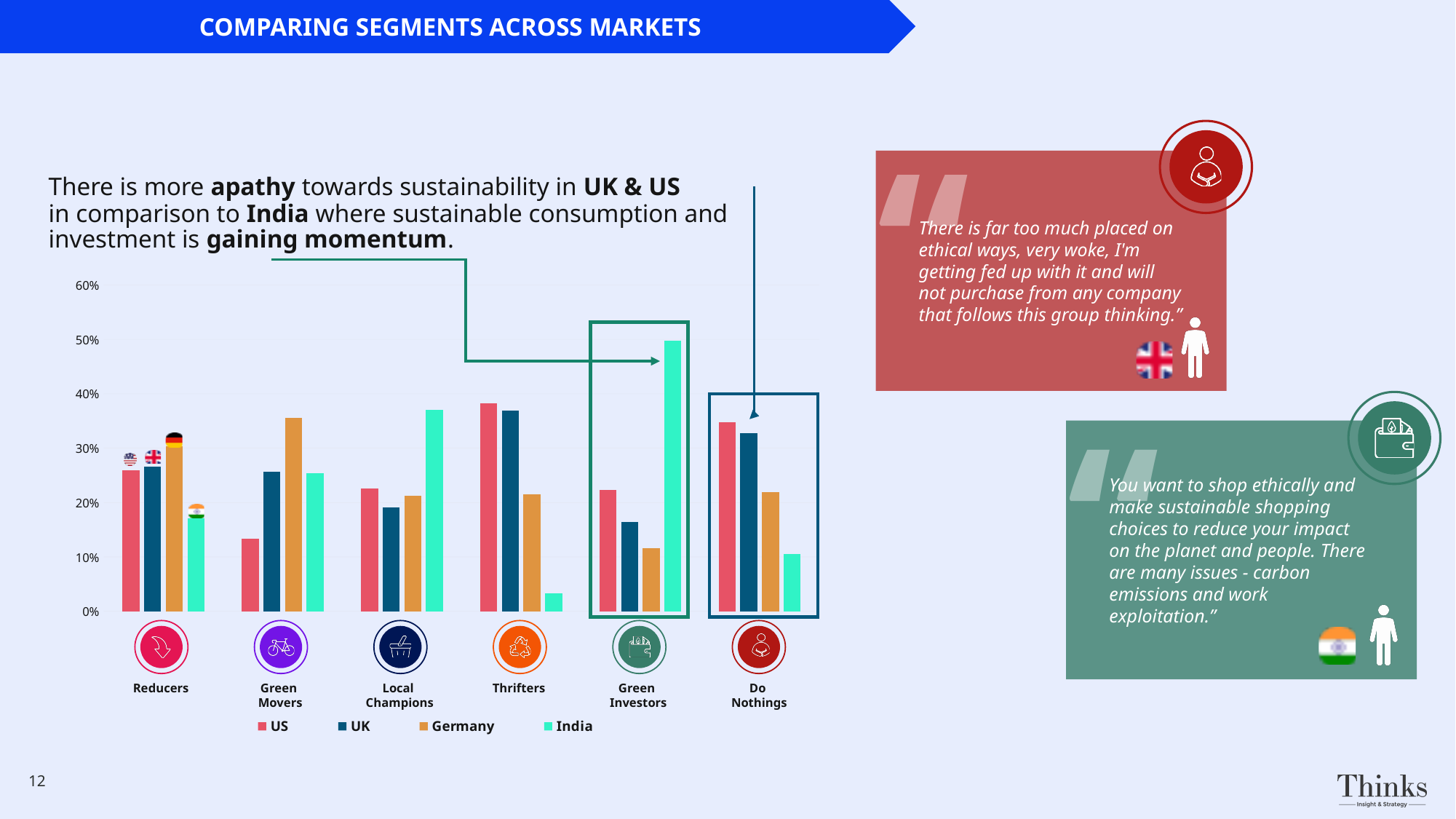
Which segment has the lowest value for India? Thrifters In the Thrifters segment, which is larger: the US value or the India value? US In the Local Champions segment, which country has the highest value? India In the Green Movers segment, which is larger: the Germany value or the US value? Germany Which four countries are listed in the chart's legend? US, UK, Germany, India How many segments (categories) are shown along the x axis of the chart? 6 What kind of chart is shown on the slide? Bar chart Is the value for Germany in the Green Movers segment greater or less than 30%? greater Which segment has the highest value for India? Green Investors Is the value for India in the Green Investors segment greater or less than 40%? greater Is the value for US in the Green Movers segment greater or less than 20%? less How many series does the chart's legend list? 4